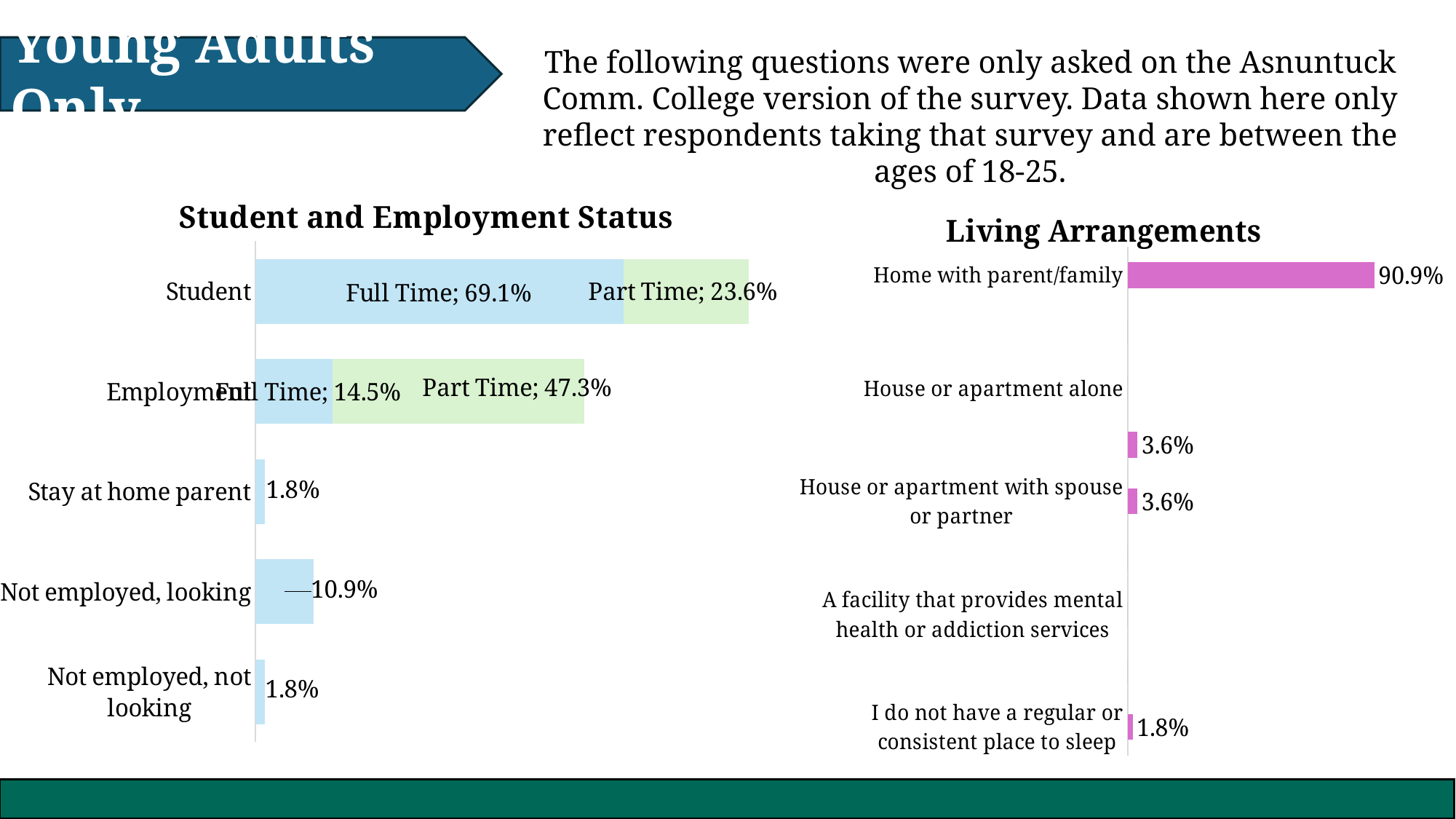
In the Living Arrangements chart, what is the value for 'I do not have a regular or consistent place to sleep'? 1.8% In the Living Arrangements chart, what is the value for House or apartment with spouse or partner? 3.6% In the Living Arrangements chart, which category has the highest value? Home with parent/family In the Student and Employment Status chart, what is the difference between the Part Time and Full Time values for Employment? 32.8% What kind of chart is the Living Arrangements chart? Bar chart In the Student and Employment Status chart, what is the Full Time value for Student? 69.1% In the Student and Employment Status chart, what is the total of the stacked Student bar (Full Time plus Part Time)? 92.7% In the Living Arrangements chart, what is the value for Home with parent/family? 90.9% In the Student and Employment Status chart, which is larger for Student: Full Time or Part Time? Full Time In the Student and Employment Status chart, what is the Part Time value for Employment? 47.3% In the Living Arrangements chart, what is the difference between Home with parent/family and 'I do not have a regular or consistent place to sleep'? 89.1% In the Student and Employment Status chart, what is the value for 'Not employed, looking'? 10.9%